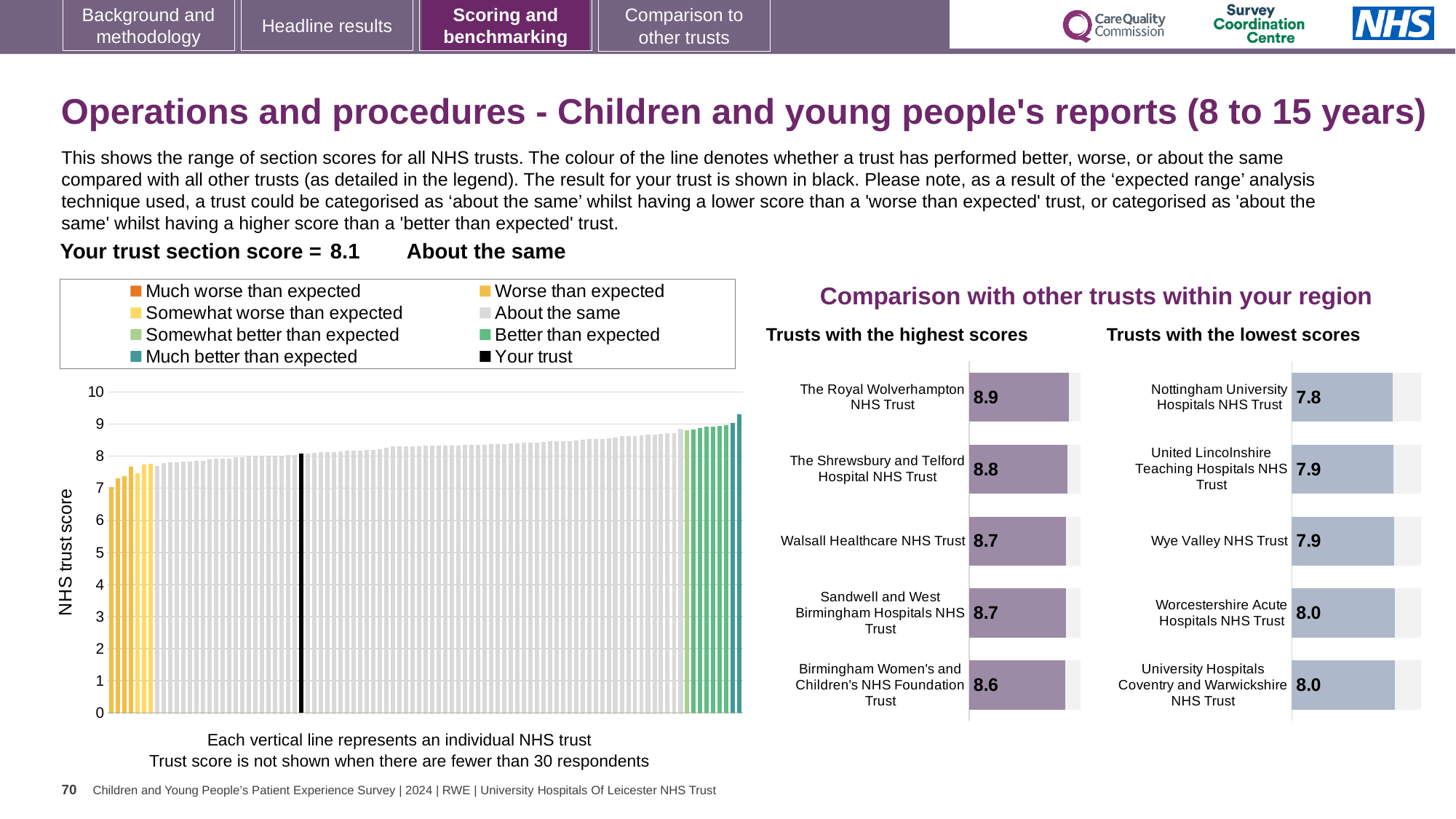
In the 'Trusts with the highest scores' chart, what is the score for Birmingham Women's and Children's NHS Foundation Trust? 8.6 In the 'Trusts with the highest scores' chart, what is the difference between the scores of The Royal Wolverhampton NHS Trust and Walsall Healthcare NHS Trust? 0.2 In the 'Trusts with the lowest scores' chart, which trust has the lowest score? Nottingham University Hospitals NHS Trust In the 'Trusts with the lowest scores' chart, what is the score for Nottingham University Hospitals NHS Trust? 7.8 In the 'Trusts with the highest scores' chart, what is the score for The Royal Wolverhampton NHS Trust? 8.9 What kind of chart is the main chart on the left showing NHS trust scores? Bar chart In the 'Trusts with the lowest scores' chart, what is the score for Worcestershire Acute Hospitals NHS Trust? 8.0 In the main chart on the left, is the value of the lowest bar greater or less than 8? less How many entries does the legend of the main chart on the left list? 8 In the 'Trusts with the lowest scores' chart, which has the larger score: Nottingham University Hospitals NHS Trust or Wye Valley NHS Trust? Wye Valley NHS Trust In the 'Trusts with the highest scores' chart, which trust has the highest score? The Royal Wolverhampton NHS Trust How many trusts are shown in the 'Trusts with the highest scores' chart? 5